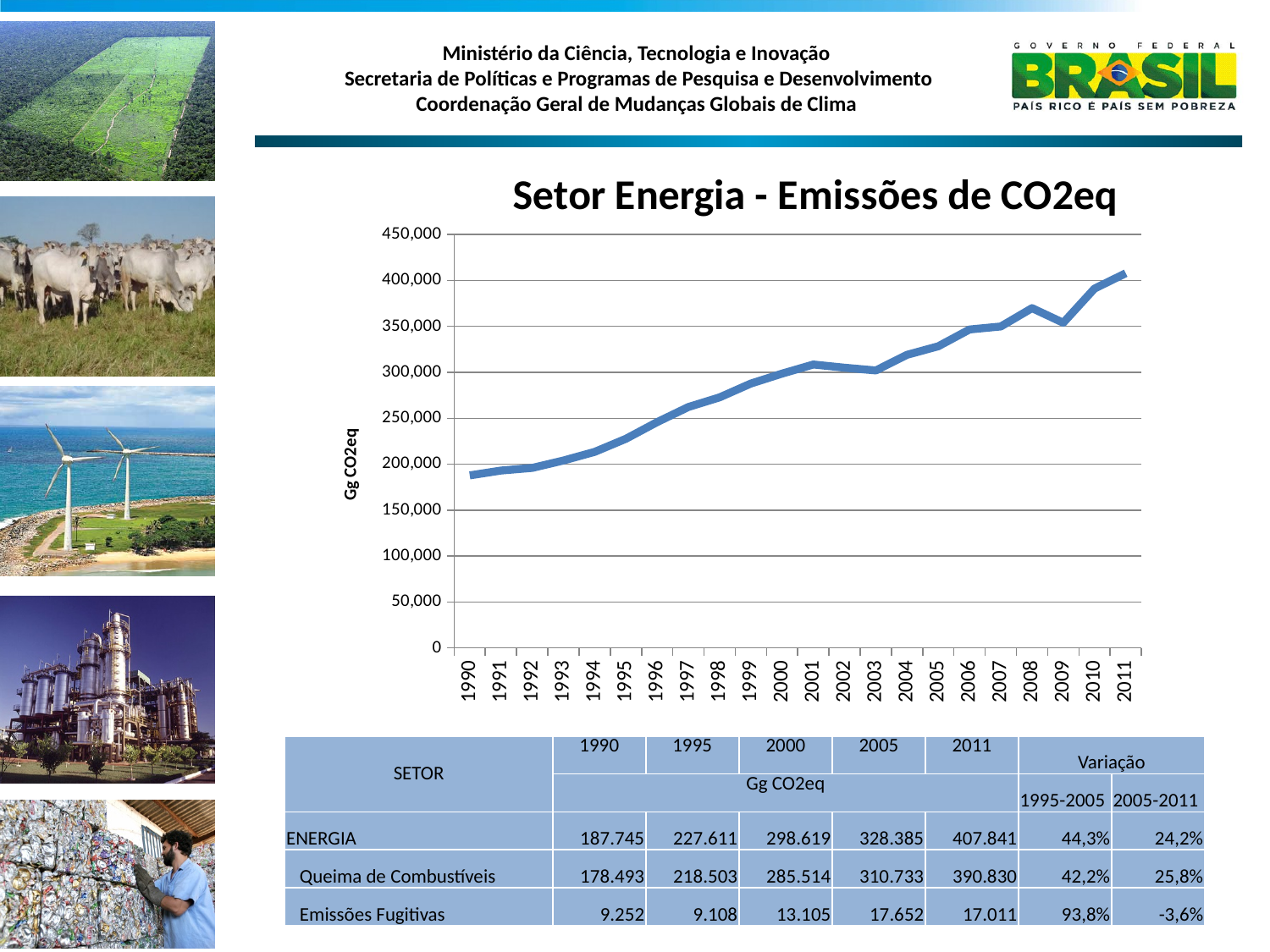
What is the label on the y axis of the chart? Gg CO2eq Which year has the highest emissions value in the chart? 2011 What type of chart is shown under the title 'Setor Energia - Emissões de CO2eq'? line chart How many years are plotted along the x axis of the chart? 22 Which year has the lowest emissions value in the chart? 1990 According to the table below the chart, what is the ENERGIA emissions value for 1990? 187.745 Do the emissions in the chart generally rise or fall from 1990 to 2011? rise Using the ENERGIA values in the table, what is the difference between the 2011 and 1990 emissions? 220.096 Is the value for 1998 in the chart greater or less than 250,000? greater According to the table below the chart, what is the ENERGIA emissions value for 2011? 407.841 Is the value for 2008 in the chart greater or less than 350,000? greater